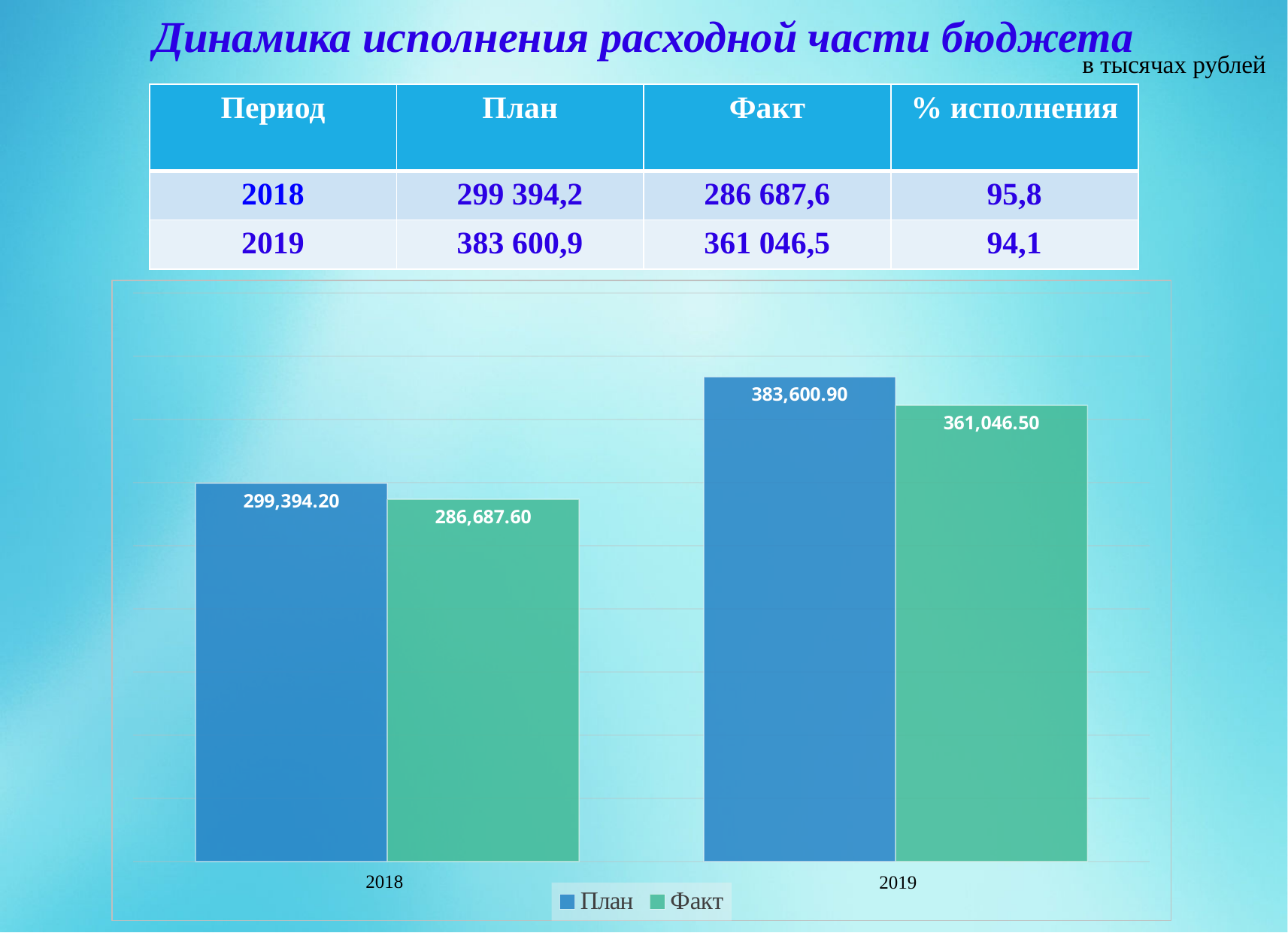
What is the value of Факт for 2018 in the chart? 286,687.60 How many categories are shown on the x axis of the chart? 2 What is the difference between План for 2019 and План for 2018 in the chart? 84,206.70 What is the value of План for 2018 in the chart? 299,394.20 Which bar in the chart has the highest value? План for 2019 Which bar in the chart has the lowest value? Факт for 2018 What type of chart is shown on the slide? Bar chart What is the value of Факт for 2019 in the chart? 361,046.50 Which is larger in the chart: Факт for 2019 or План for 2018? Факт for 2019 What is the value of План for 2019 in the chart? 383,600.90 How many series does the chart legend list? 2 What is the difference between План and Факт for 2019 in the chart? 22,554.40